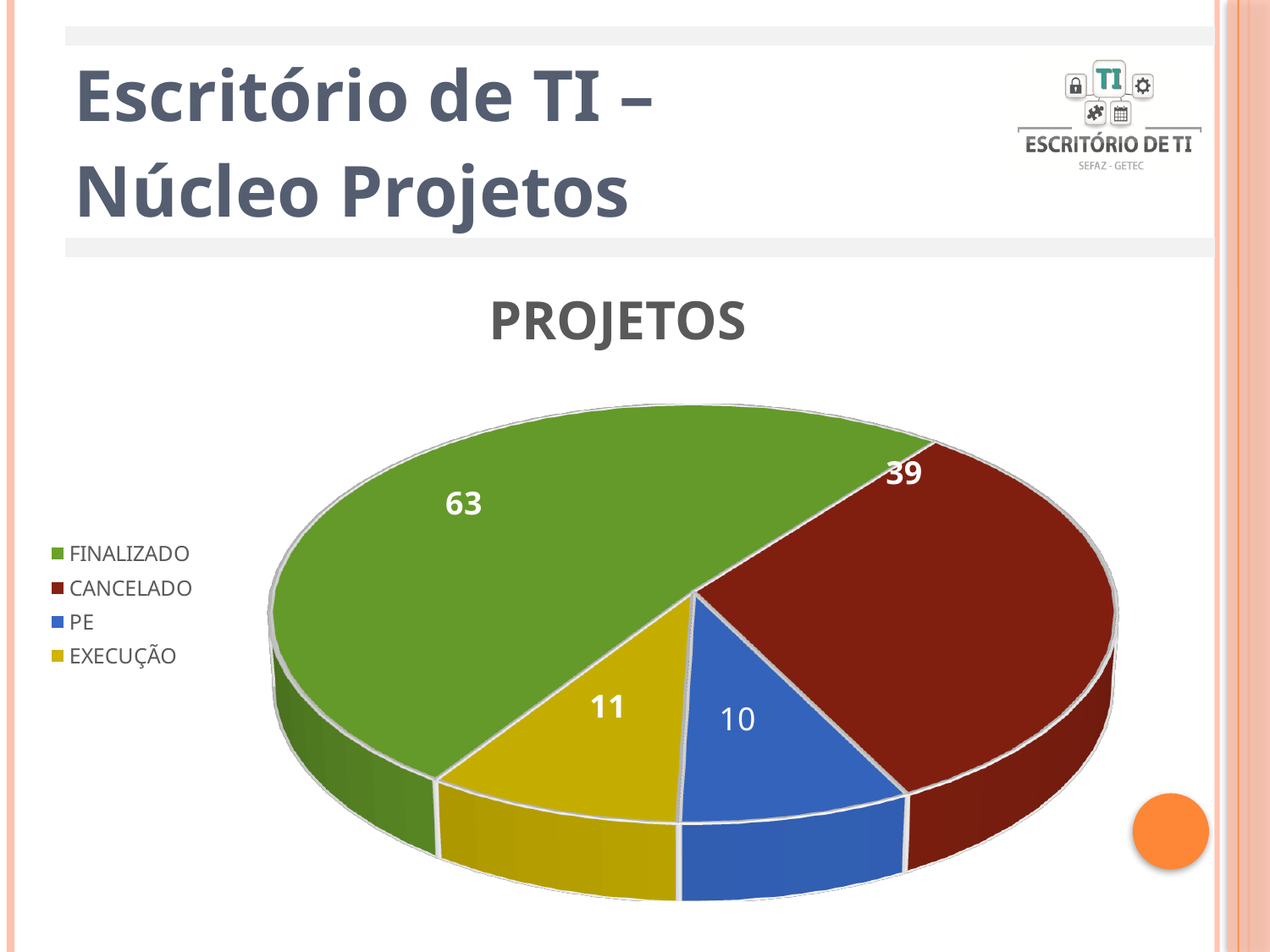
What is the total of all slices in the PROJETOS pie chart? 123 What kind of chart is shown on the slide? Pie chart Which category has the smallest slice in the PROJETOS pie chart? PE Which is larger in the PROJETOS chart, EXECUÇÃO or PE? EXECUÇÃO What is the value for EXECUÇÃO in the PROJETOS pie chart? 11 Which category has the largest slice in the PROJETOS pie chart? FINALIZADO What is the value for PE in the PROJETOS pie chart? 10 How many categories are shown in the PROJETOS pie chart? 4 What colour is the CANCELADO slice in the PROJETOS pie chart? Dark red What is the value for CANCELADO in the PROJETOS pie chart? 39 What is the difference between the FINALIZADO and CANCELADO values in the PROJETOS chart? 24 What is the value for FINALIZADO in the PROJETOS pie chart? 63